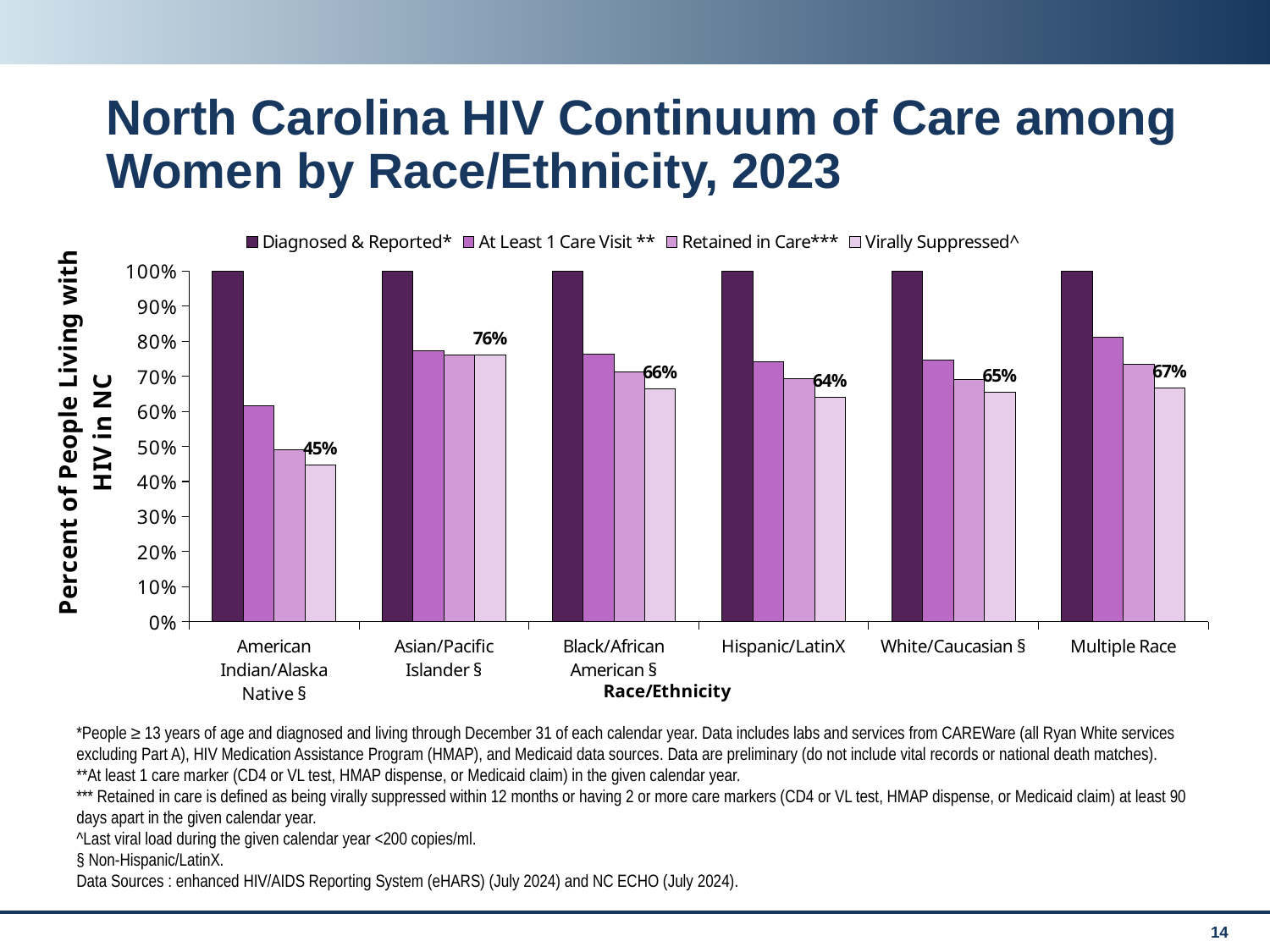
What is the Virally Suppressed value for Multiple Race women? 67% What is the Virally Suppressed value for Asian/Pacific Islander women? 76% Which race/ethnicity group has the lowest Virally Suppressed percentage? American Indian/Alaska Native What is the Virally Suppressed value for American Indian/Alaska Native women? 45% Is the At Least 1 Care Visit value for American Indian/Alaska Native women greater or less than 70%? less How many series does the legend list? 4 How many race/ethnicity categories are shown on the x axis? 6 Which race/ethnicity group has the highest Virally Suppressed percentage? Asian/Pacific Islander Is the Retained in Care value for Asian/Pacific Islander women greater or less than 70%? greater What is the Virally Suppressed value for Hispanic/LatinX women? 64% What is the difference in Virally Suppressed percentage between Asian/Pacific Islander and American Indian/Alaska Native women? 31 percentage points Which group has a higher Virally Suppressed percentage, Black/African American or Hispanic/LatinX? Black/African American